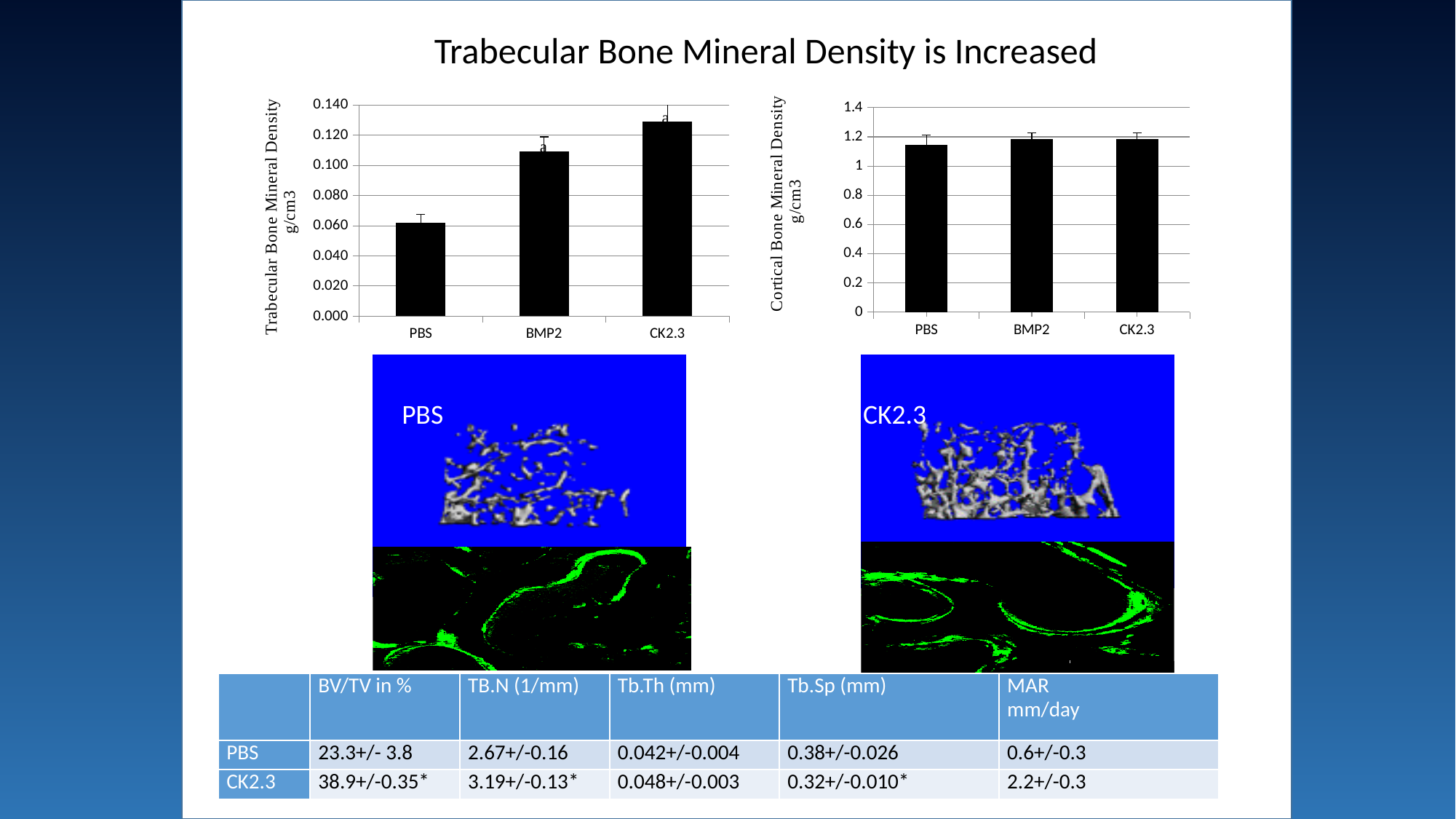
On the Trabecular Bone Mineral Density chart, which is larger, the value for PBS or the value for BMP2? BMP2 On the Trabecular Bone Mineral Density chart, do the bars rise or fall from PBS to CK2.3? rise On the Trabecular Bone Mineral Density chart, which group has the lowest bar? PBS On the Trabecular Bone Mineral Density chart, is the value for CK2.3 greater or less than 0.120? greater On the Trabecular Bone Mineral Density chart, which group has the highest bar? CK2.3 How many groups are shown on the Trabecular Bone Mineral Density chart? 3 On the Trabecular Bone Mineral Density chart, is the value for BMP2 greater or less than 0.100? greater What unit is shown on the y-axis of the Cortical Bone Mineral Density chart? g/cm3 On the Cortical Bone Mineral Density chart, is the value for CK2.3 greater or less than 1? greater What kind of chart is the Cortical Bone Mineral Density chart? bar chart